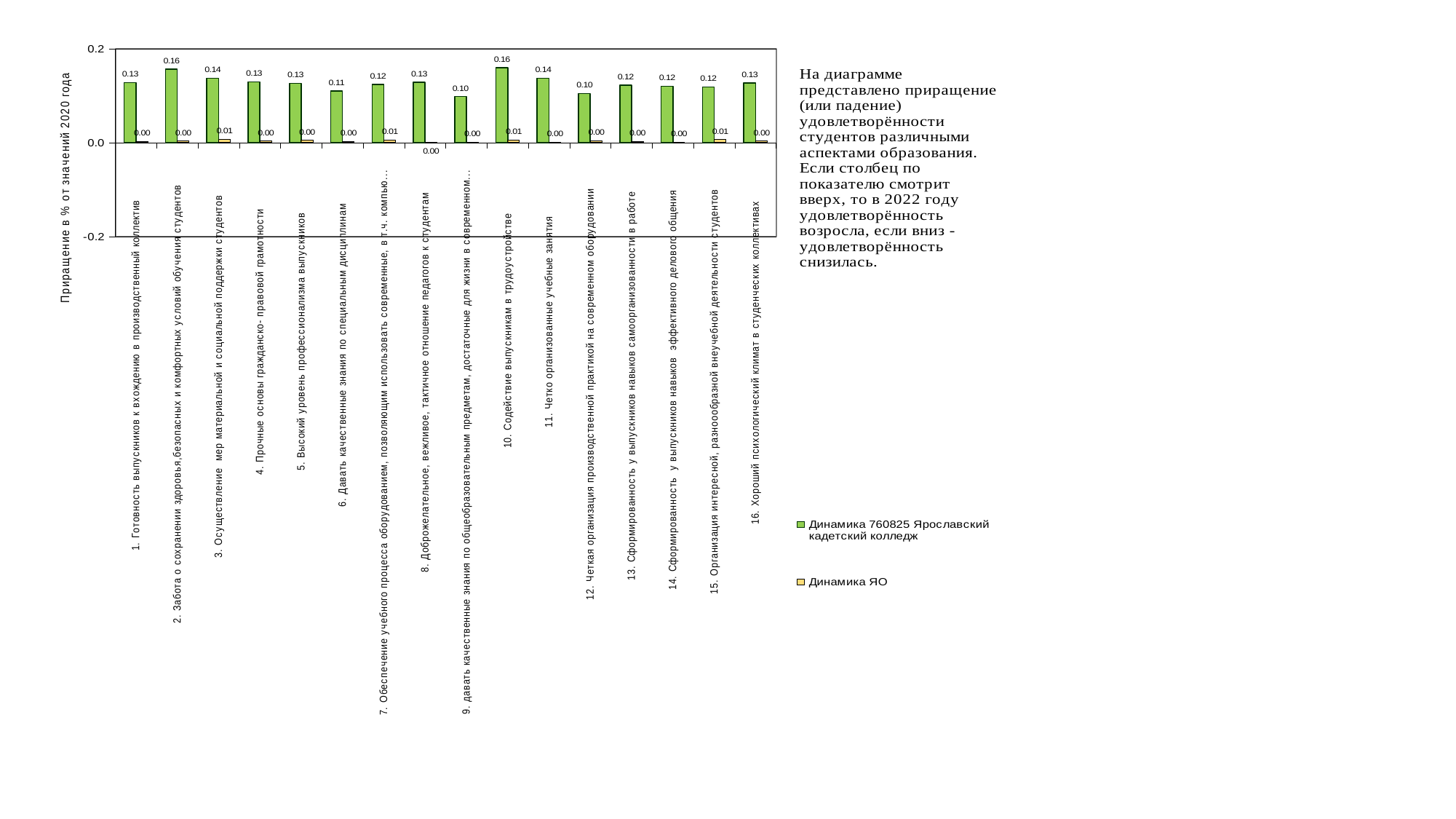
What is the value of the 'Динамика ЯО' series for category '3. Осуществление мер материальной и социальной поддержки студентов'? 0.01 For category '2. Забота о сохранении здоровья, безопасных и комфортных условий обучения студентов', what is the difference between the 'Динамика 760825 Ярославский кадетский колледж' value and the 'Динамика ЯО' value? 0.16 Which has a larger 'Динамика 760825 Ярославский кадетский колледж' value: category 2 (Забота о сохранении здоровья...) or category 9 (давать качественные знания по общеобразовательным предметам...)? Category 2 What is the highest value shown for the 'Динамика 760825 Ярославский кадетский колледж' series? 0.16 How many categories are shown on the x axis of the chart? 16 What is the value of the 'Динамика 760825 Ярославский кадетский колледж' series for category '12. Четкая организация производственной практикой на современном оборудовании'? 0.10 How many series does the chart legend list? 2 Is the 'Динамика 760825 Ярославский кадетский колледж' value for category 3 greater or less than 0.2? less What is the value of the 'Динамика 760825 Ярославский кадетский колледж' series for category '6. Давать качественные знания по специальным дисциплинам'? 0.11 What type of chart is shown on the slide? Bar chart What is the value of the 'Динамика 760825 Ярославский кадетский колледж' series for category '10. Содействие выпускникам в трудоустройстве'? 0.16 What is the difference between the 'Динамика 760825 Ярославский кадетский колледж' values for category 10 (Содействие выпускникам в трудоустройстве) and category 9 (давать качественные знания по общеобразовательным предметам)? 0.06